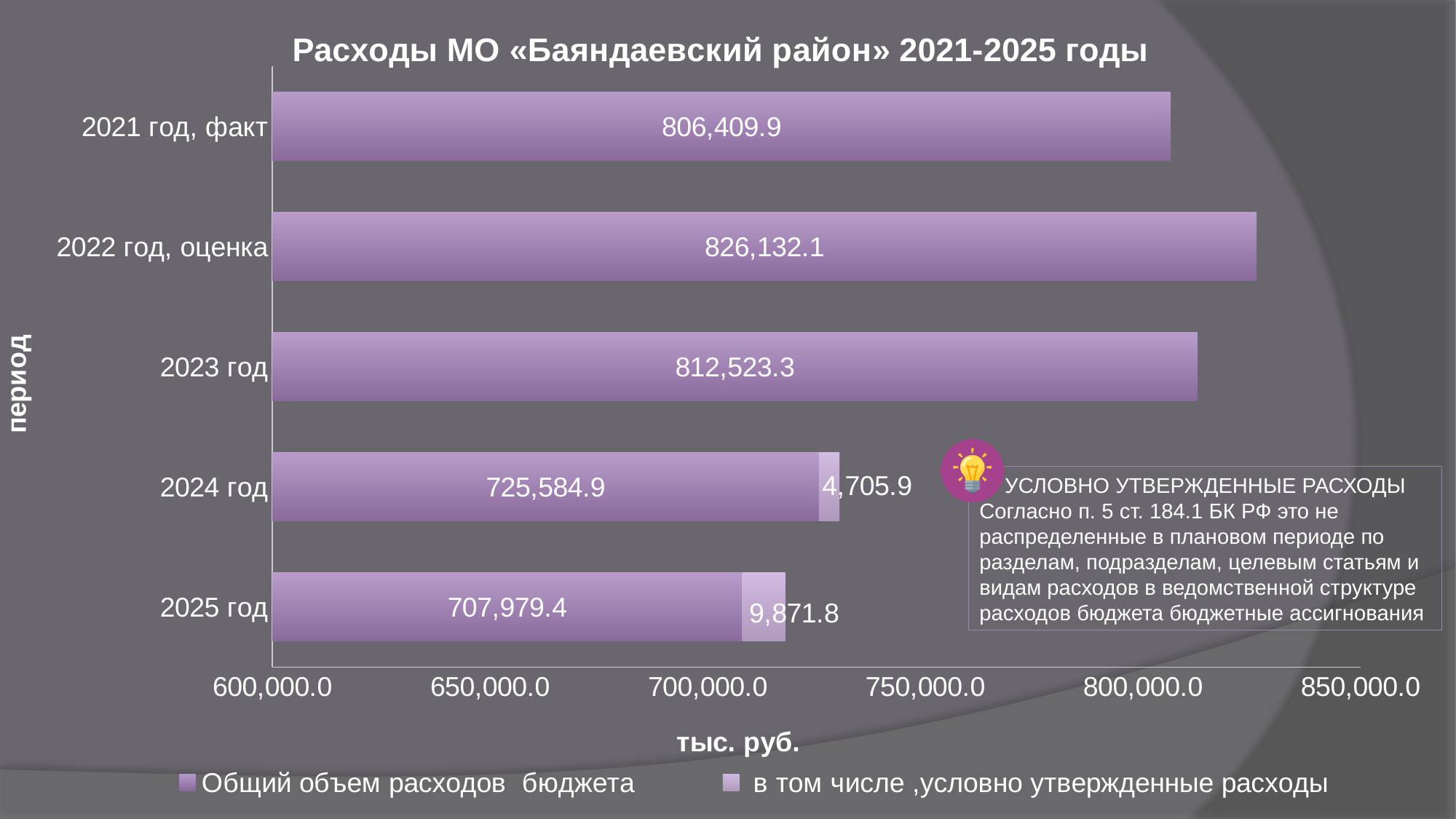
Is the 'Общий объем расходов бюджета' value for '2023 год' greater or less than 800,000.0? greater What is the total of the stacked bar for '2024 год'? 730,290.8 What is the value of 'в том числе ,условно утвержденные расходы' for '2025 год'? 9,871.8 Which is larger: the 'в том числе ,условно утвержденные расходы' value for '2024 год' or for '2025 год'? 2025 год How many series does the legend list? 2 What is the difference between the 'Общий объем расходов бюджета' values for '2022 год, оценка' and '2021 год, факт'? 19,722.2 Which period has the lowest value of 'Общий объем расходов бюджета'? 2025 год How many periods (categories) are shown on the chart? 5 Which period has the highest value of 'Общий объем расходов бюджета'? 2022 год, оценка What is the value of 'Общий объем расходов бюджета' for '2021 год, факт'? 806,409.9 What type of chart is shown on the slide? Bar chart What is the value of 'Общий объем расходов бюджета' for '2022 год, оценка'? 826,132.1